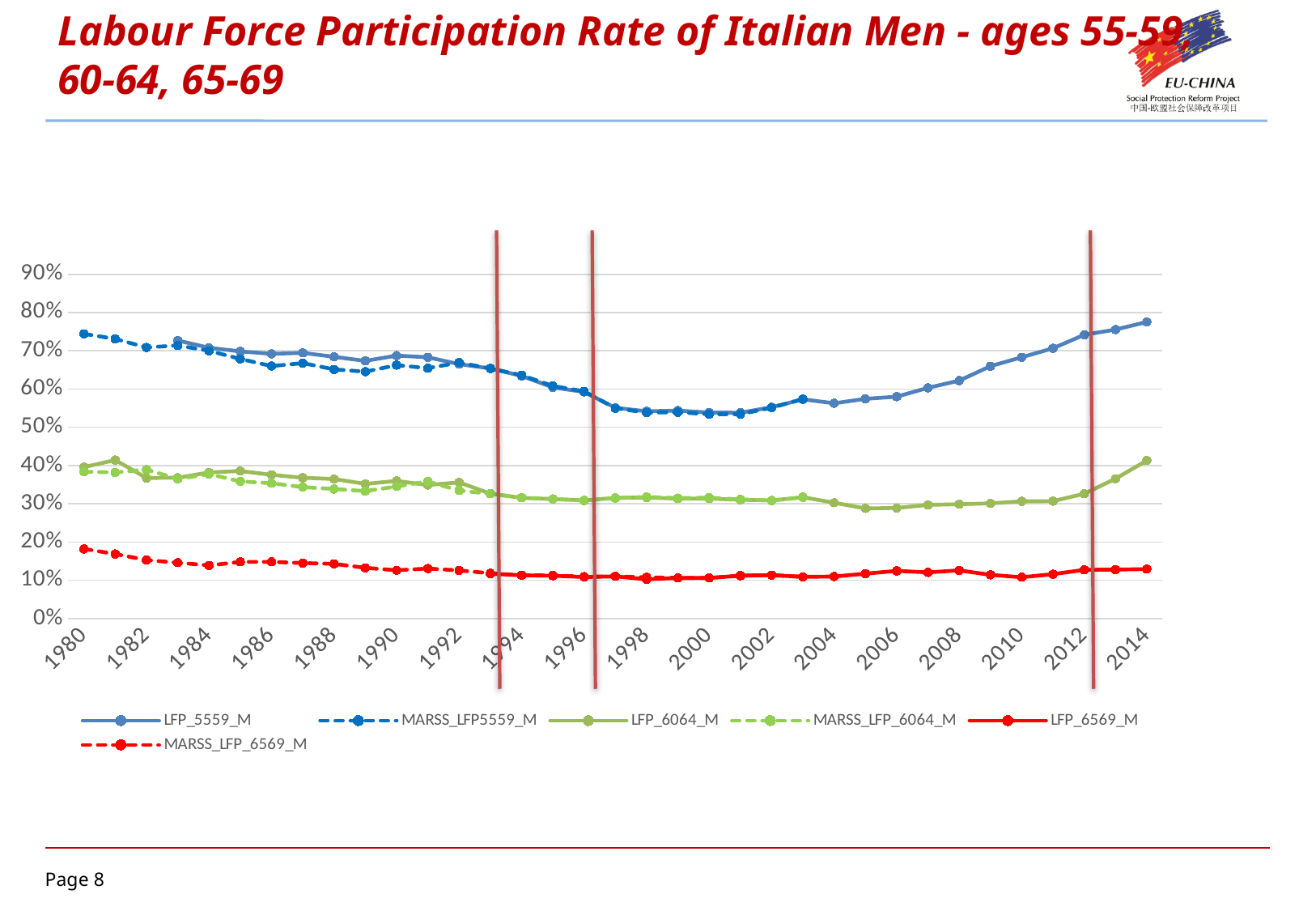
Is the value for LFP_5559_M in 2014 greater or less than 70%? greater In 2010, which is larger: LFP_5559_M or LFP_6064_M? LFP_5559_M For LFP_6064_M, which year has the larger value: 2006 or 2014? 2014 Is the value for LFP_6569_M in 2000 greater or less than 20%? less Does LFP_5559_M rise or fall between 2006 and 2014? rise How many vertical red lines are drawn over the chart? 3 Is the value for LFP_6064_M in 2006 greater or less than 40%? less What kind of chart is shown on the slide? line chart How many series does the legend list? 6